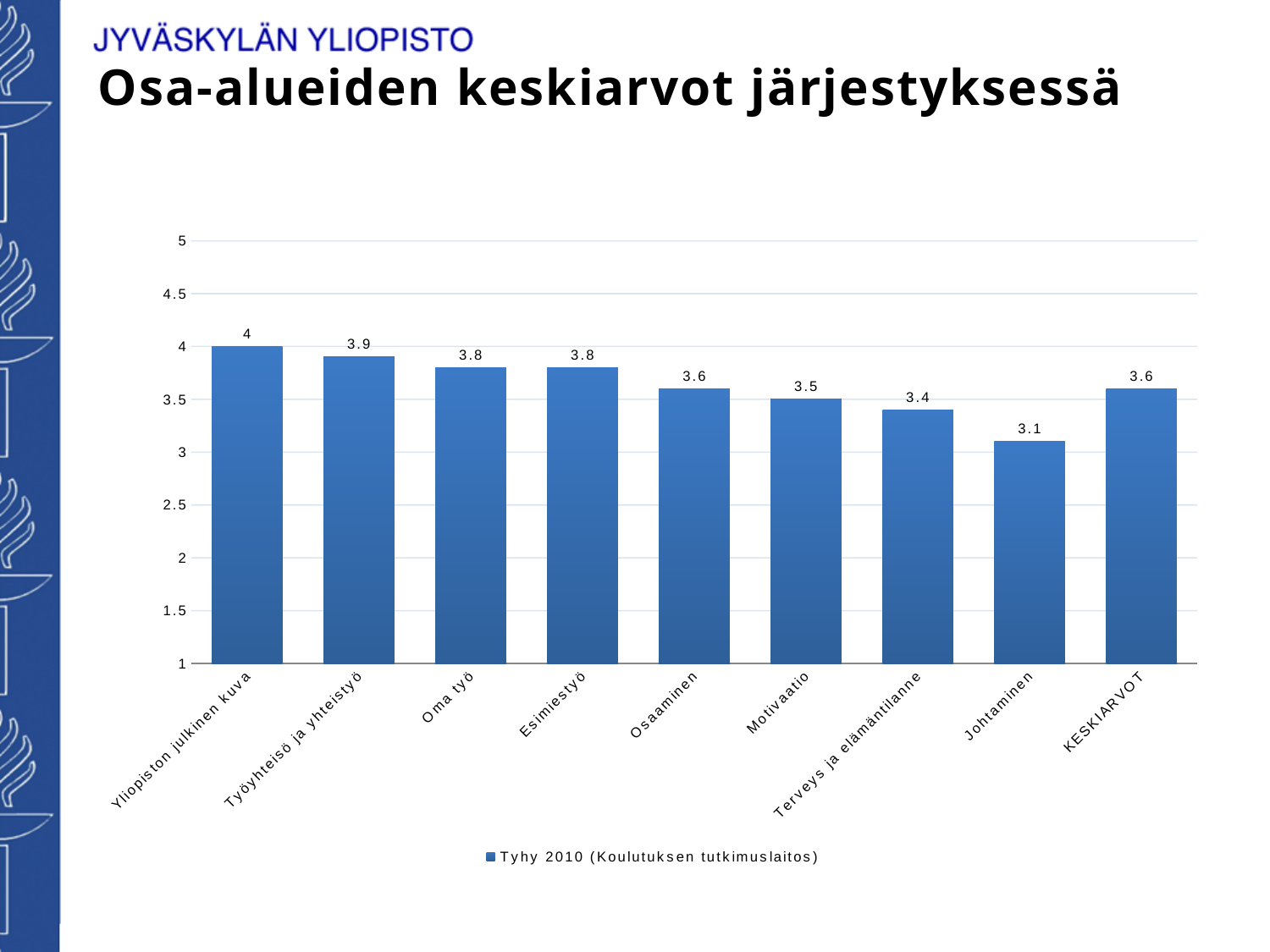
What is the value for Johtaminen? 3.1 What kind of chart is shown on the slide? Bar chart Which is larger, the value for Motivaatio or the value for Osaaminen? Osaaminen What is the difference between the values for Yliopiston julkinen kuva and Johtaminen? 0.9 What is the value for KESKIARVOT? 3.6 How many categories are shown on the x axis? 9 What is the value for Yliopiston julkinen kuva? 4 What is the legend entry for the series? Tyhy 2010 (Koulutuksen tutkimuslaitos) Which category has the lowest value? Johtaminen What is the value for Terveys ja elämäntilanne? 3.4 Which category has the highest value? Yliopiston julkinen kuva How many series does the legend list? 1